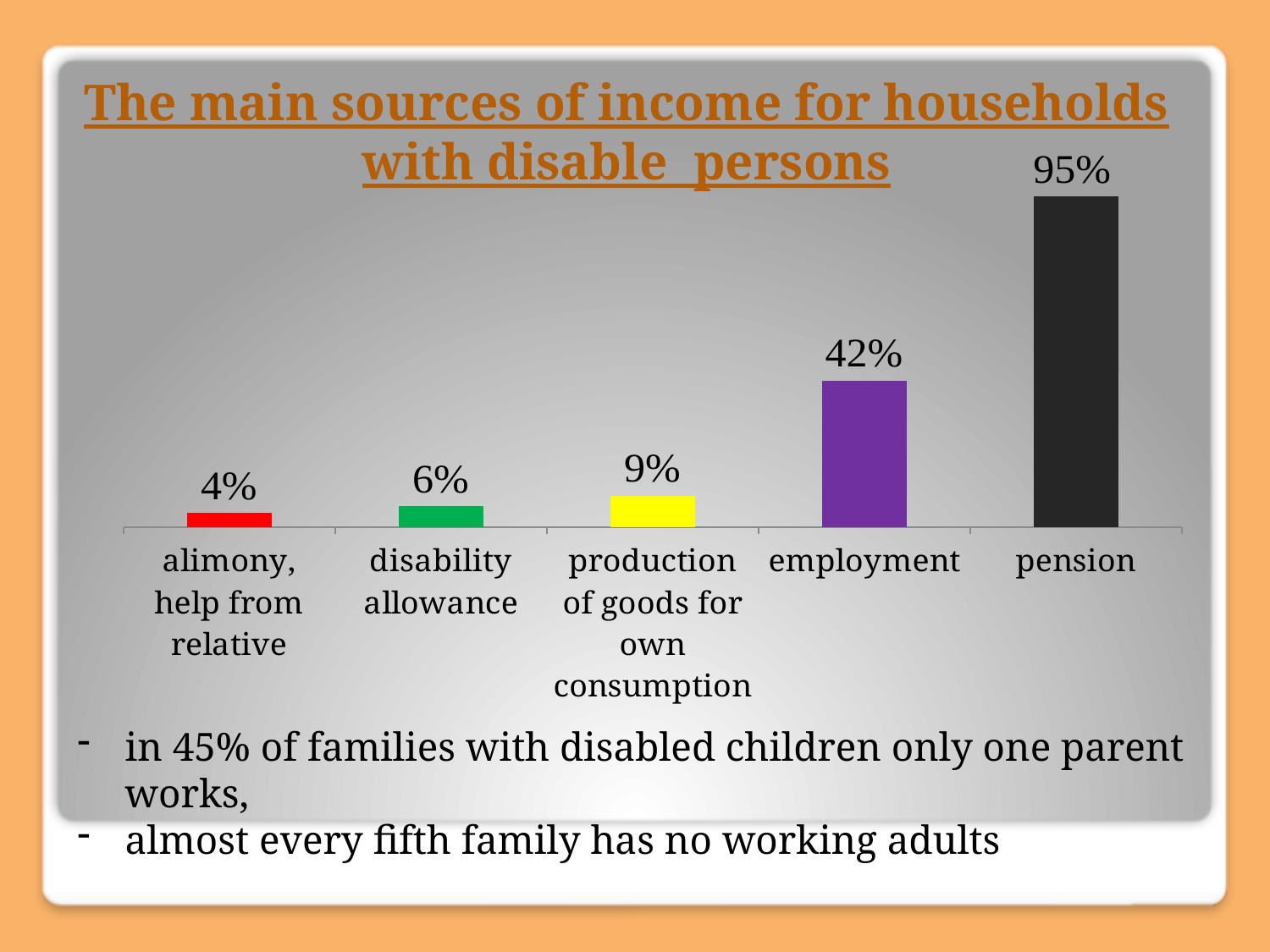
What is the value for pension? 95% What is the difference between the values for pension and employment? 53% Which source of income has the lowest value? alimony, help from relative What is the value for disability allowance? 6% What is the title of the chart? The main sources of income for households with disable persons Which is larger, the value for employment or the value for disability allowance? employment What is the value for production of goods for own consumption? 9% Which source of income has the highest value? pension What kind of chart is shown on the slide? bar chart What is the value for employment? 42% How many categories are shown in the chart? 5 What is the difference between the values for production of goods for own consumption and alimony, help from relative? 5%